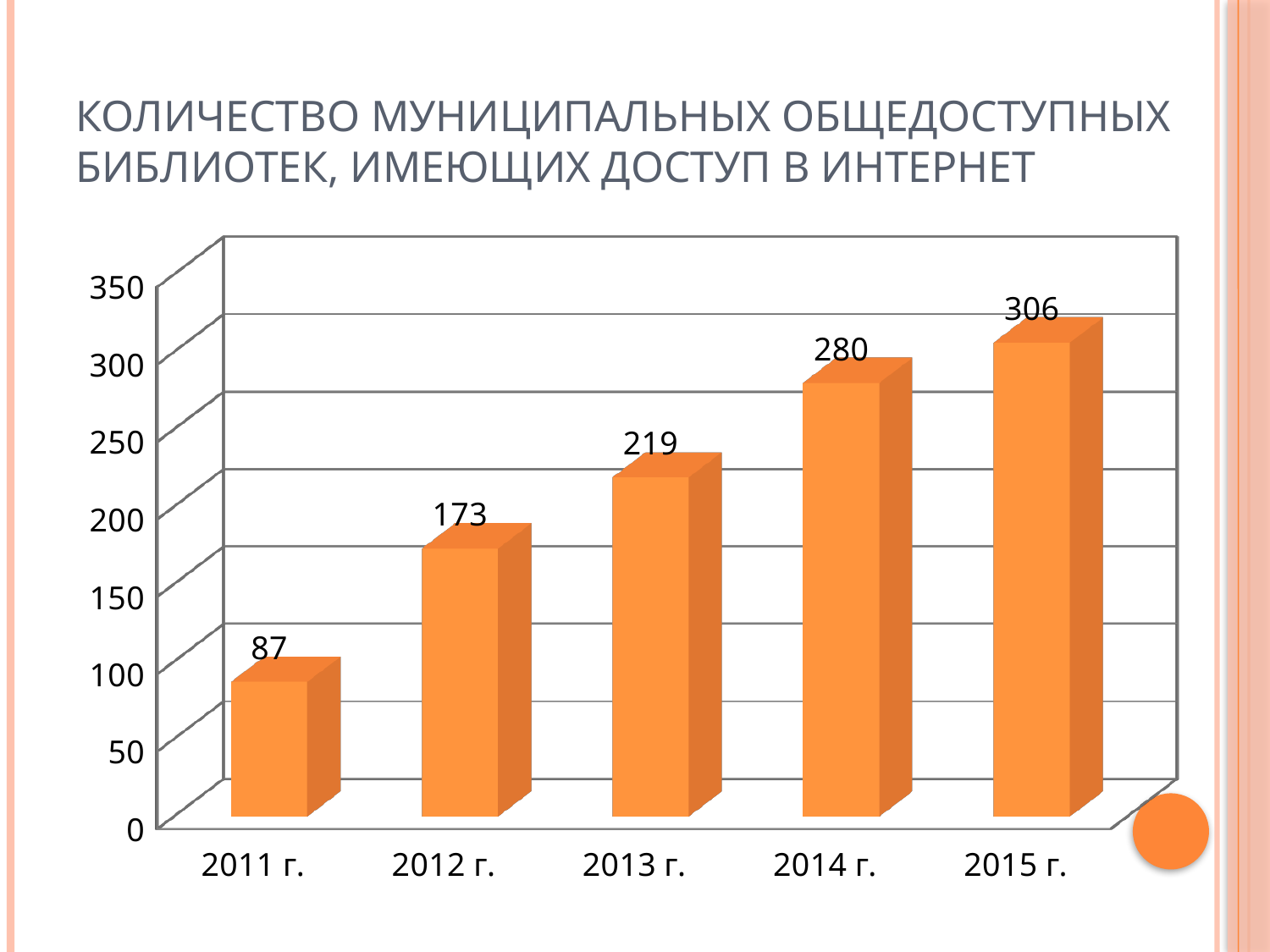
Which year has the lowest value? 2011 г. What is the value for 2015 г.? 306 What is the difference between the values for 2015 г. and 2011 г.? 219 How many years are shown on the x axis? 5 What is the value for 2013 г.? 219 Is the value for 2014 г. greater or less than 250? greater What kind of chart is shown on the slide? bar chart Do the values rise or fall from 2011 г. to 2015 г.? rise Which is larger, the value for 2012 г. or the value for 2013 г.? 2013 г. What is the difference between the values for 2014 г. and 2012 г.? 107 Which year has the highest value? 2015 г. What is the value for 2011 г.? 87